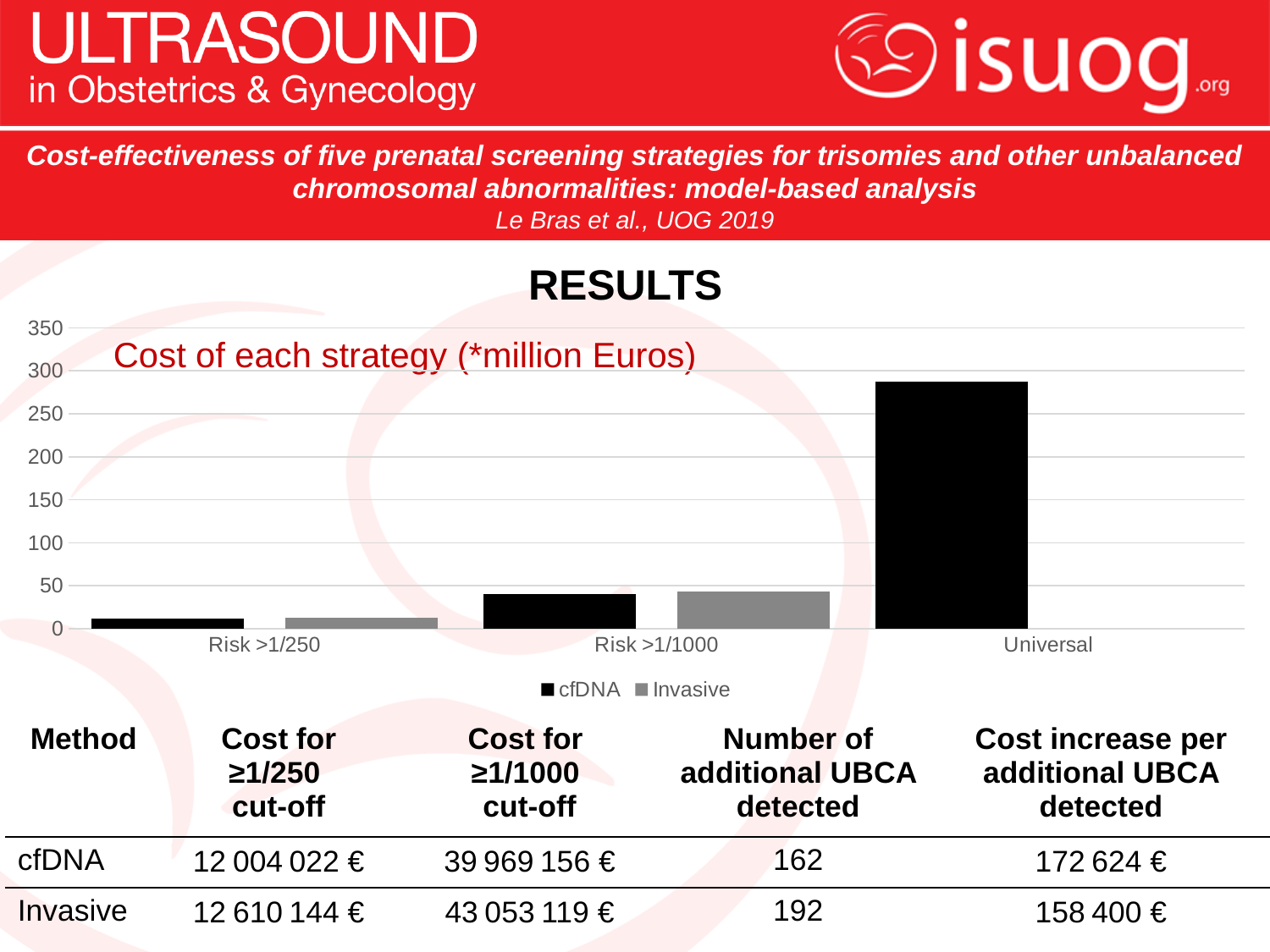
Which category has the highest cfDNA value in the chart? Universal Is the cfDNA value for Universal greater or less than 300? less Which is larger: the Invasive value for Risk >1/250 or the Invasive value for Risk >1/1000? Risk >1/1000 What is the title of the chart? Cost of each strategy (*million Euros) How many series does the chart legend list? 2 Is the cfDNA value for Universal greater or less than 250? greater How many categories are shown on the x axis of the chart? 3 What kind of chart is shown on the slide? bar chart Which is larger: the cfDNA value for Universal or the cfDNA value for Risk >1/1000? Universal Which category has the lowest cfDNA value in the chart? Risk >1/250 Do the cfDNA values rise or fall from Risk >1/250 to Universal along the x axis? rise